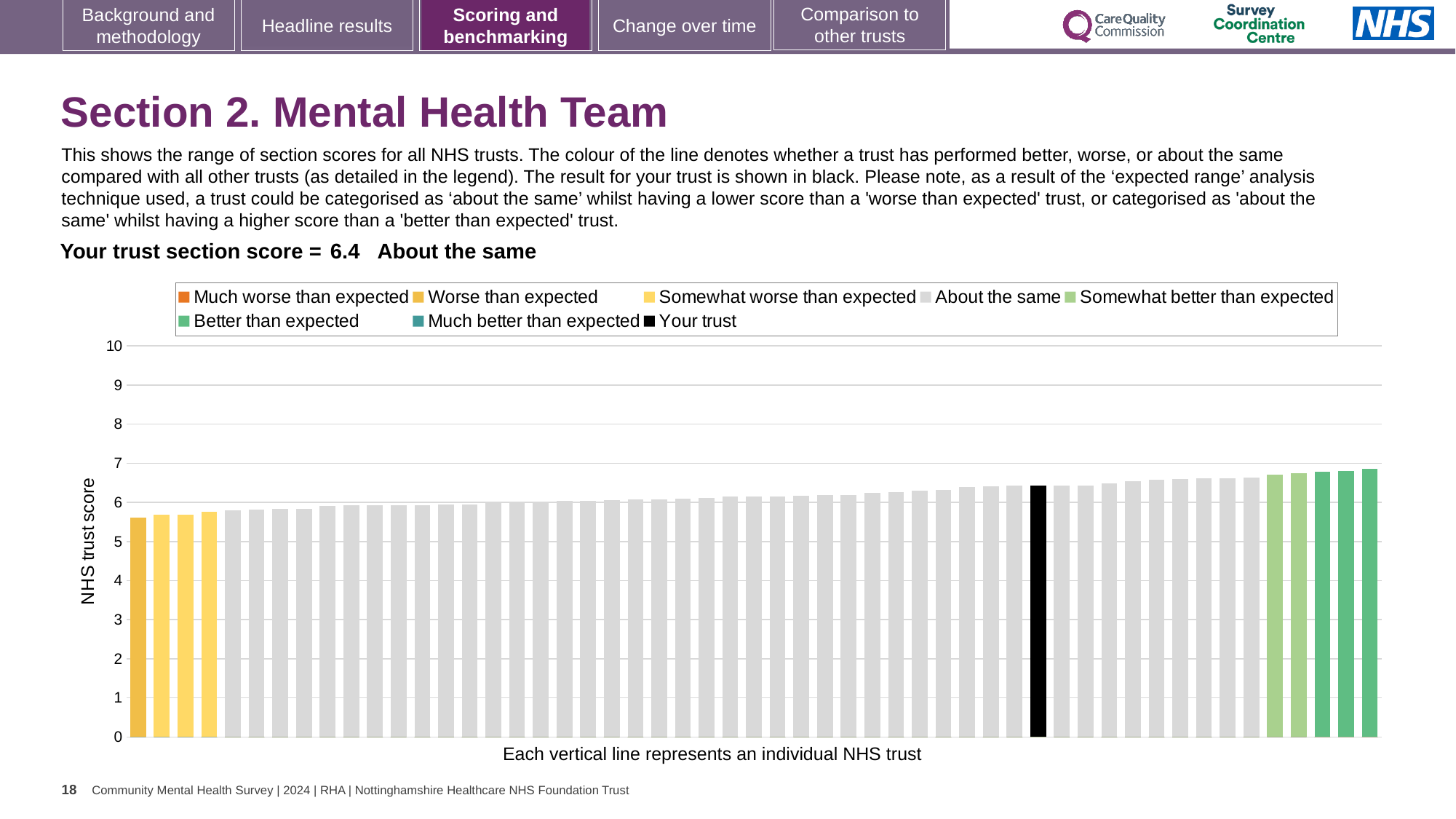
Is the value of the lowest bar in the chart greater or less than 6? less How many entries does the chart legend list? 8 Do the bar values rise or fall from left to right across the chart? rise Is the value of the black 'Your trust' bar greater or less than 6? greater What is the trust's section score for Section 2. Mental Health Team? 6.4 What colour is used for the bar representing your trust? black What kind of chart is shown on the slide? bar chart Is the value of the lowest bar in the chart greater or less than 5? greater What is the label on the vertical axis of the chart? NHS trust score Is the black 'Your trust' bar higher or lower than the leftmost bar in the chart? higher Which benchmarking category is the trust's section score placed in? About the same